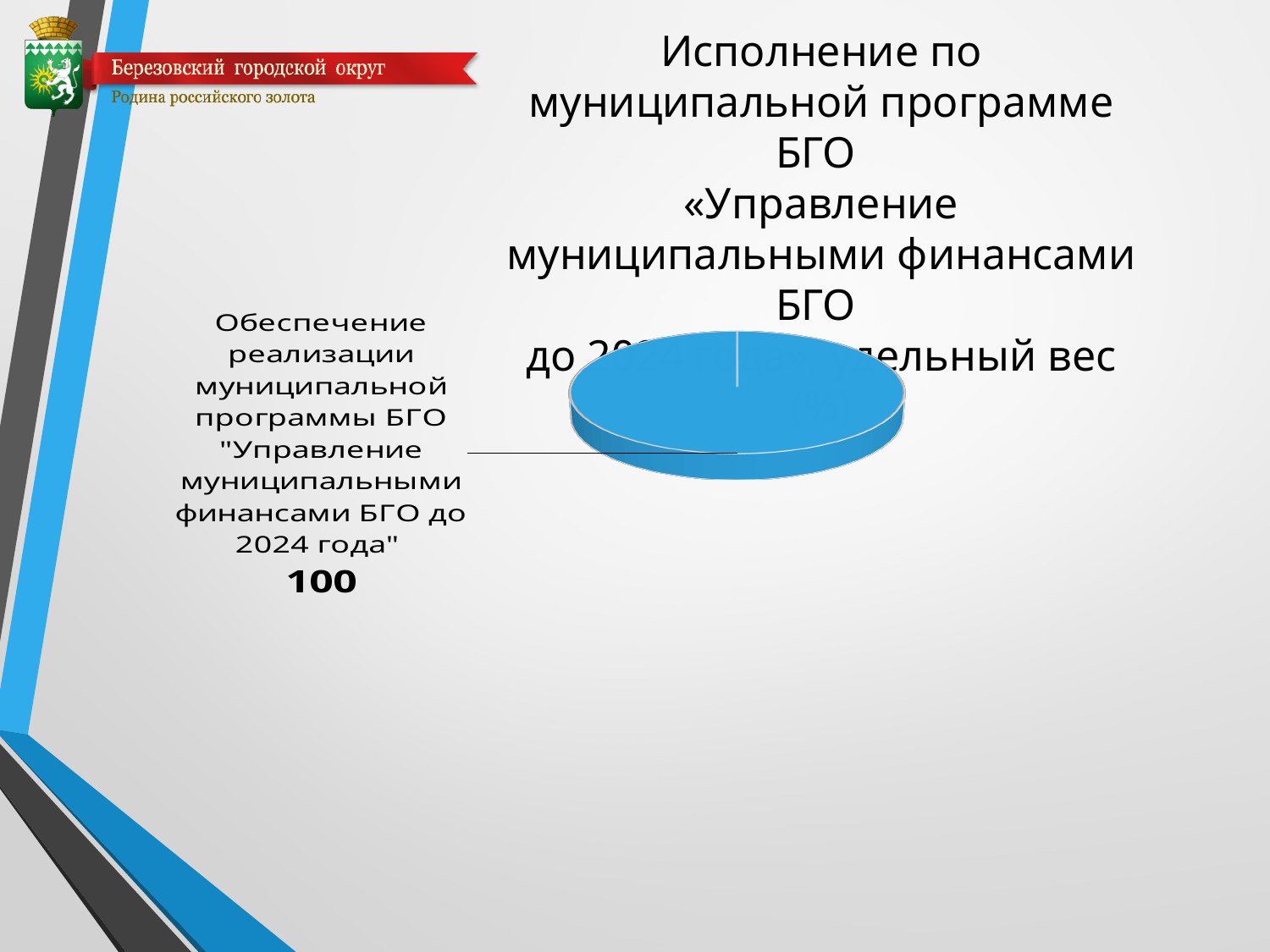
What colour is the single slice of the pie chart? blue What kind of chart is shown on the slide? pie chart Is the value for the slice "Обеспечение реализации муниципальной программы БГО "Управление муниципальными финансами БГО до 2024 года"" greater or less than 50? greater What share of the pie does the slice "Обеспечение реализации муниципальной программы БГО "Управление муниципальными финансами БГО до 2024 года"" take up? 100% What value is shown for the slice "Обеспечение реализации муниципальной программы БГО "Управление муниципальными финансами БГО до 2024 года""? 100 How many slices does the pie chart have? 1 Is the pie chart drawn in 3D or flat? 3D